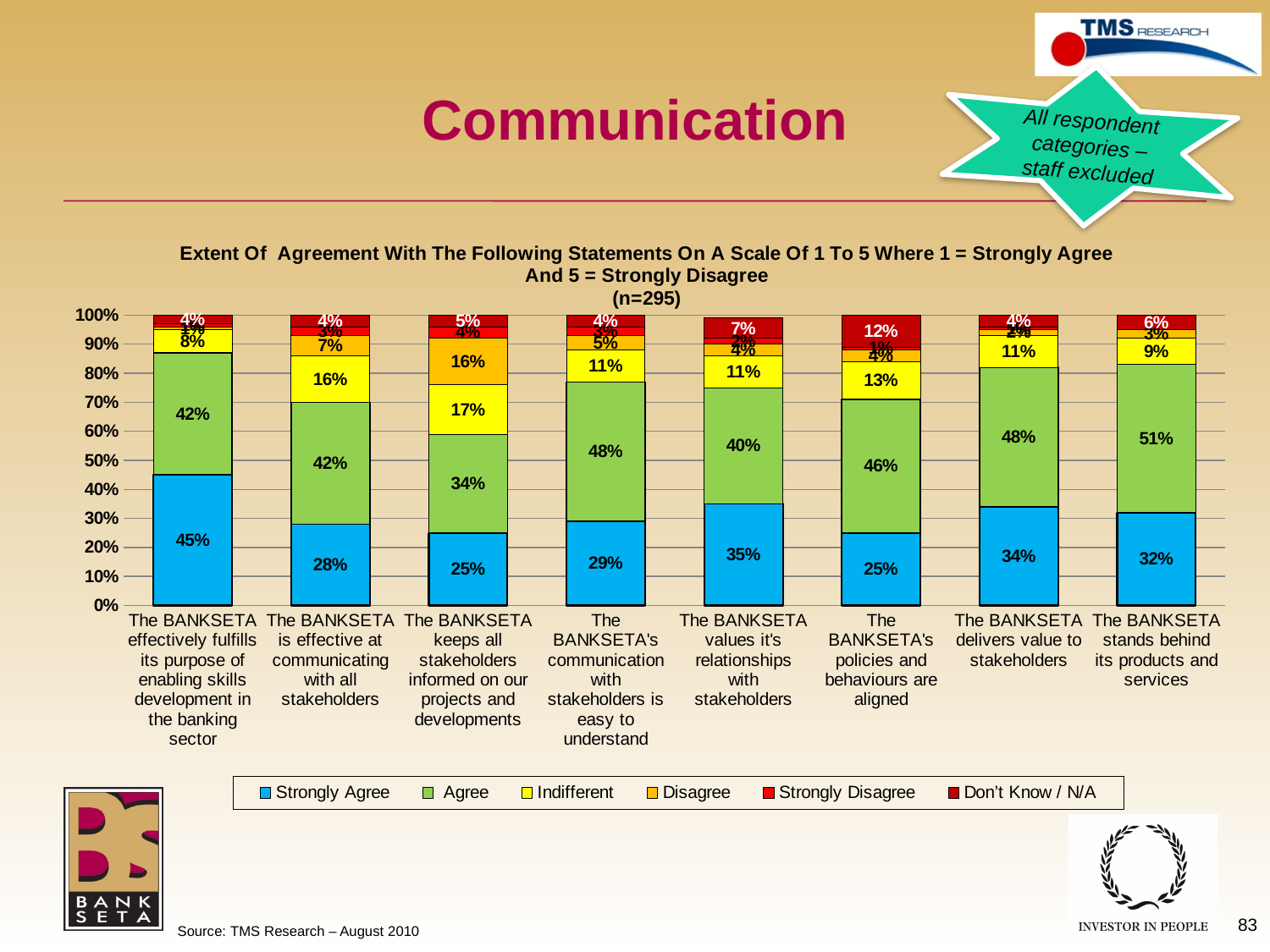
How many series does the legend list? 6 What is the sample size (n) stated in the chart title? n=295 What type of chart is shown on the slide? Stacked bar chart How many statements (categories) are plotted on the chart? 8 What is the Agree value for 'The BANKSETA stands behind its products and services'? 51% What percentage of respondents strongly agree that the BANKSETA effectively fulfills its purpose of enabling skills development in the banking sector? 45% Which statement has the highest Strongly Agree percentage? The BANKSETA effectively fulfills its purpose of enabling skills development in the banking sector Which is larger: the Disagree value for 'The BANKSETA keeps all stakeholders informed on our projects and developments' or the Disagree value for 'The BANKSETA is effective at communicating with all stakeholders'? The BANKSETA keeps all stakeholders informed on our projects and developments What is the Indifferent value for 'The BANKSETA keeps all stakeholders informed on our projects and developments'? 17% What is the difference between the Strongly Agree values for 'The BANKSETA values it's relationships with stakeholders' and 'The BANKSETA delivers value to stakeholders'? 1% Which statement has the lowest Agree percentage? The BANKSETA keeps all stakeholders informed on our projects and developments What is the Don't Know / N/A value for 'The BANKSETA's policies and behaviours are aligned'? 12%